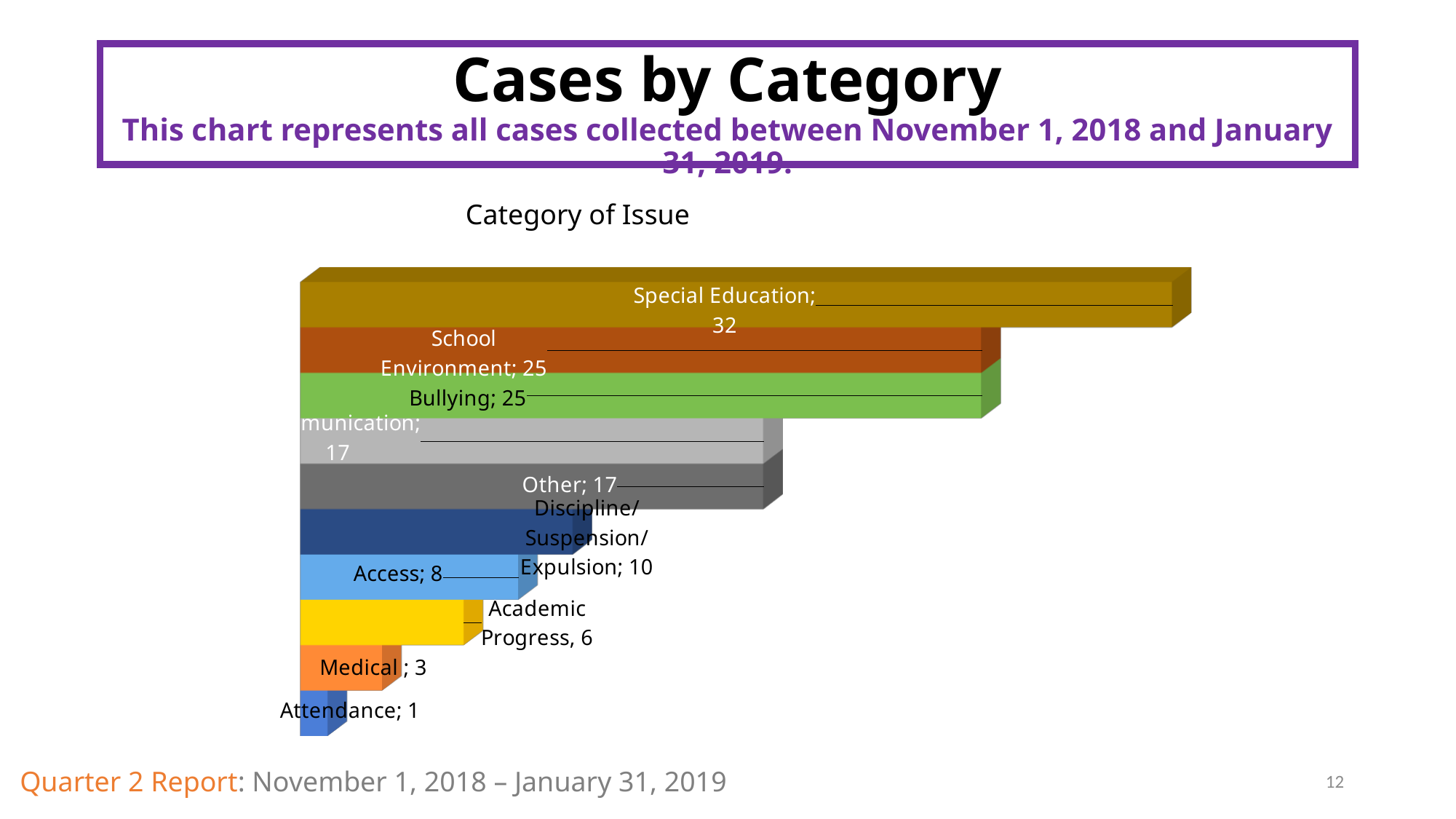
What is the difference between the number of cases for Other and Access? 9 What is the title of the chart? Category of Issue How many categories are shown in the chart? 10 Which category has the highest number of cases? Special Education What is the difference between the number of cases for Special Education and School Environment? 7 Which has more cases, Access or Medical? Access How many cases are in the Bullying category? 25 How many cases are in the Special Education category? 32 What kind of chart is shown on the slide? Bar chart How many cases are in the Academic Progress category? 6 How many cases are in the Discipline/Suspension/Expulsion category? 10 Which category has the lowest number of cases? Attendance